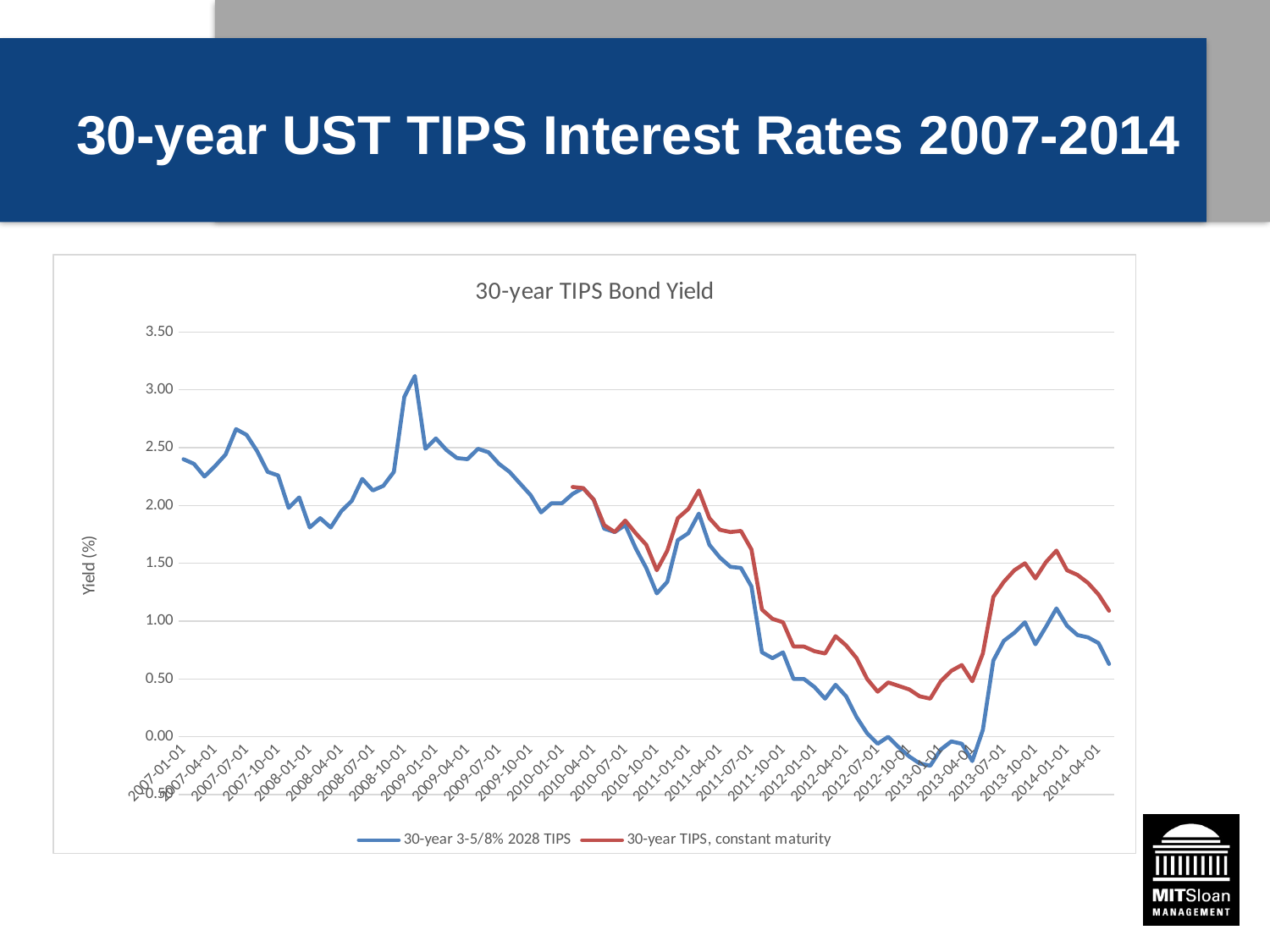
What is the label on the vertical axis of the chart? Yield (%) At 2013-07-01, which series has the higher yield: 30-year 3-5/8% 2028 TIPS or 30-year TIPS, constant maturity? 30-year TIPS, constant maturity Is the value of the 30-year 3-5/8% 2028 TIPS series at 2012-10-01 greater or less than 0.50? less Is the value of the 30-year 3-5/8% 2028 TIPS series at 2007-01-01 greater or less than 2.00? greater What is the title of the chart? 30-year TIPS Bond Yield What kind of chart is shown on the slide? Line chart Does the 30-year 3-5/8% 2028 TIPS series rise or fall between 2011-04-01 and 2012-10-01? fall How many series does the legend of the chart list? 2 At 2012-04-01, which series has the higher yield: 30-year 3-5/8% 2028 TIPS or 30-year TIPS, constant maturity? 30-year TIPS, constant maturity Is the value of the 30-year TIPS, constant maturity series at 2012-01-01 greater or less than 1.00? less Does the 30-year TIPS, constant maturity series rise or fall between 2013-04-01 and 2013-10-01? rise Which series reaches the highest yield shown on the chart? 30-year 3-5/8% 2028 TIPS